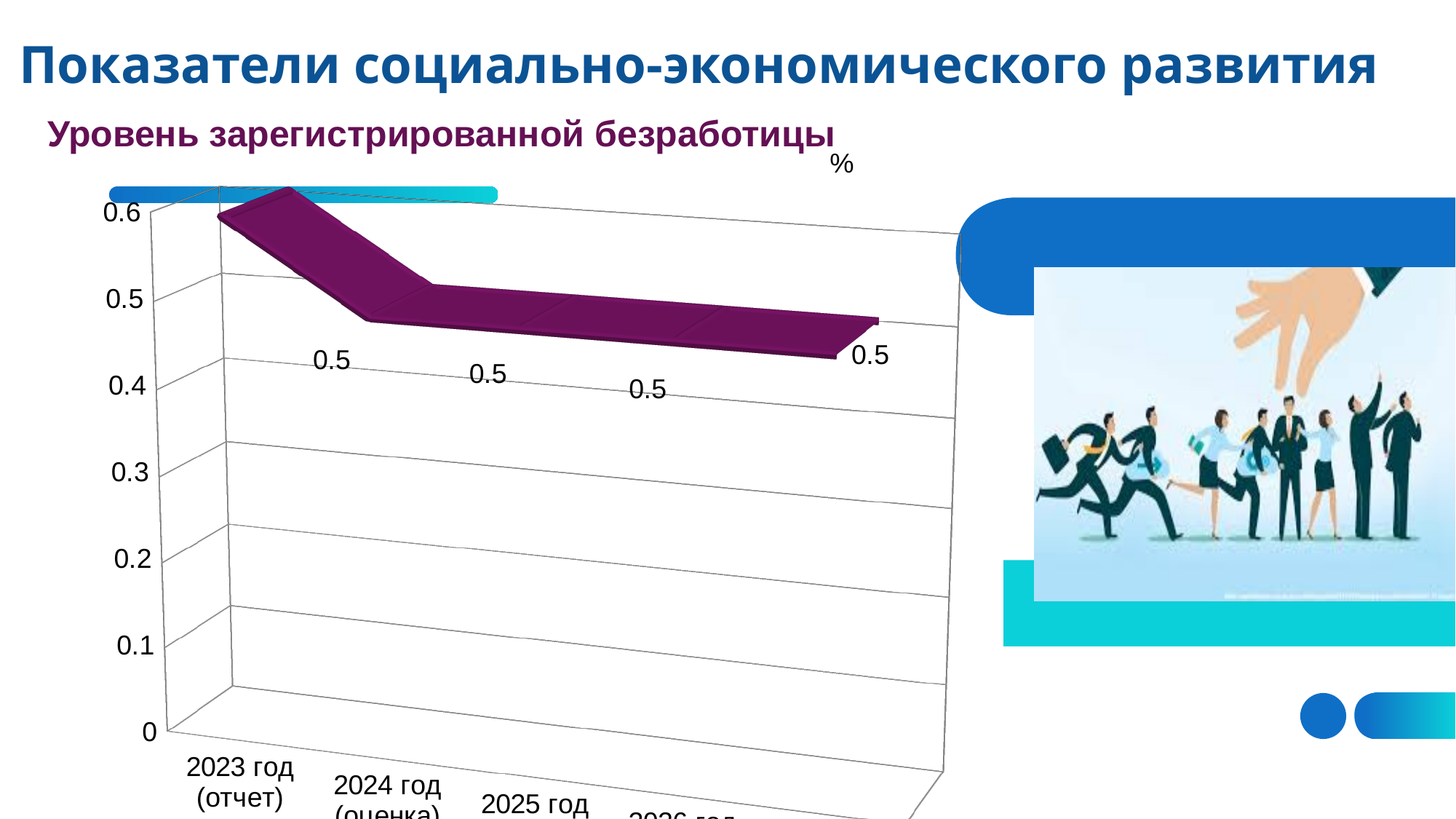
What is the difference between the values for 2024 год (оценка) and 2025 год? 0 What unit is indicated for the chart's values? % What is the value for 2024 год (оценка)? 0.5 What is the title of the chart? Уровень зарегистрированной безработицы Is the value for 2023 год (отчет) greater or less than 0.5? greater Do the values rise or fall from 2023 год (отчет) to 2024 год (оценка)? fall Which is larger, the value for 2023 год (отчет) or the value for 2024 год (оценка)? 2023 год (отчет) What kind of chart is shown on the slide? line chart Which year has the highest value on the chart? 2023 год (отчет) What is the value for 2025 год? 0.5 Is the value for 2024 год (оценка) greater or less than 0.6? less